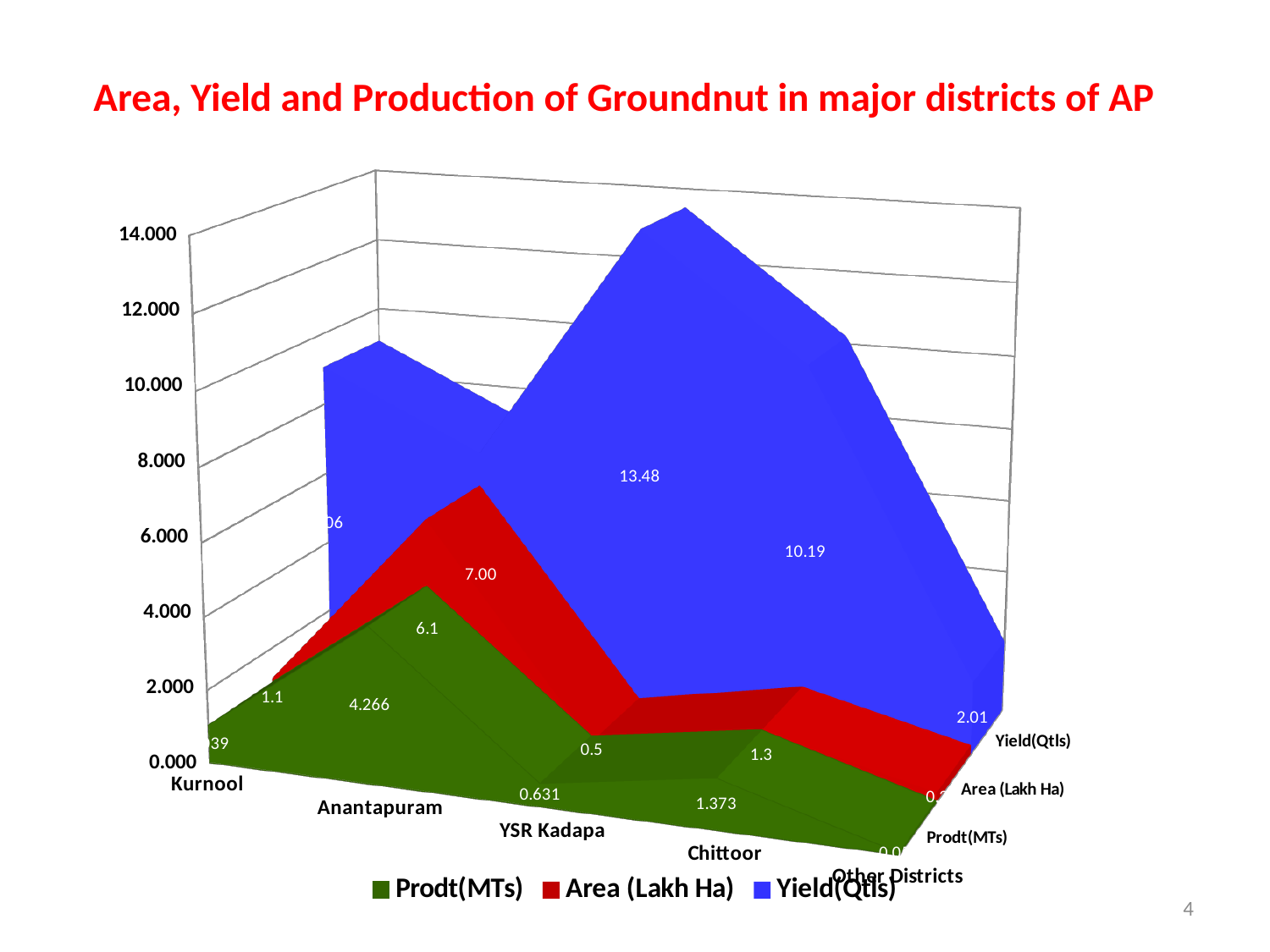
What kind of chart is shown on the slide? Area chart What is the Area (Lakh Ha) value for Anantapuram? 6.1 Which is larger, the Prodt(MTs) value for Chittoor or for YSR Kadapa? Chittoor What is the Prodt(MTs) value for Anantapuram? 4.266 Which district has the highest Yield(Qtls)? YSR Kadapa How many districts are shown on the x axis? 5 What is the Yield(Qtls) value for Chittoor? 10.19 How many series does the legend list? 3 What is the Yield(Qtls) value for YSR Kadapa? 13.48 What is the difference between the Yield(Qtls) values for YSR Kadapa and Chittoor? 3.29 What is the Yield(Qtls) value for Other Districts? 2.01 Which district has the highest Prodt(MTs)? Anantapuram